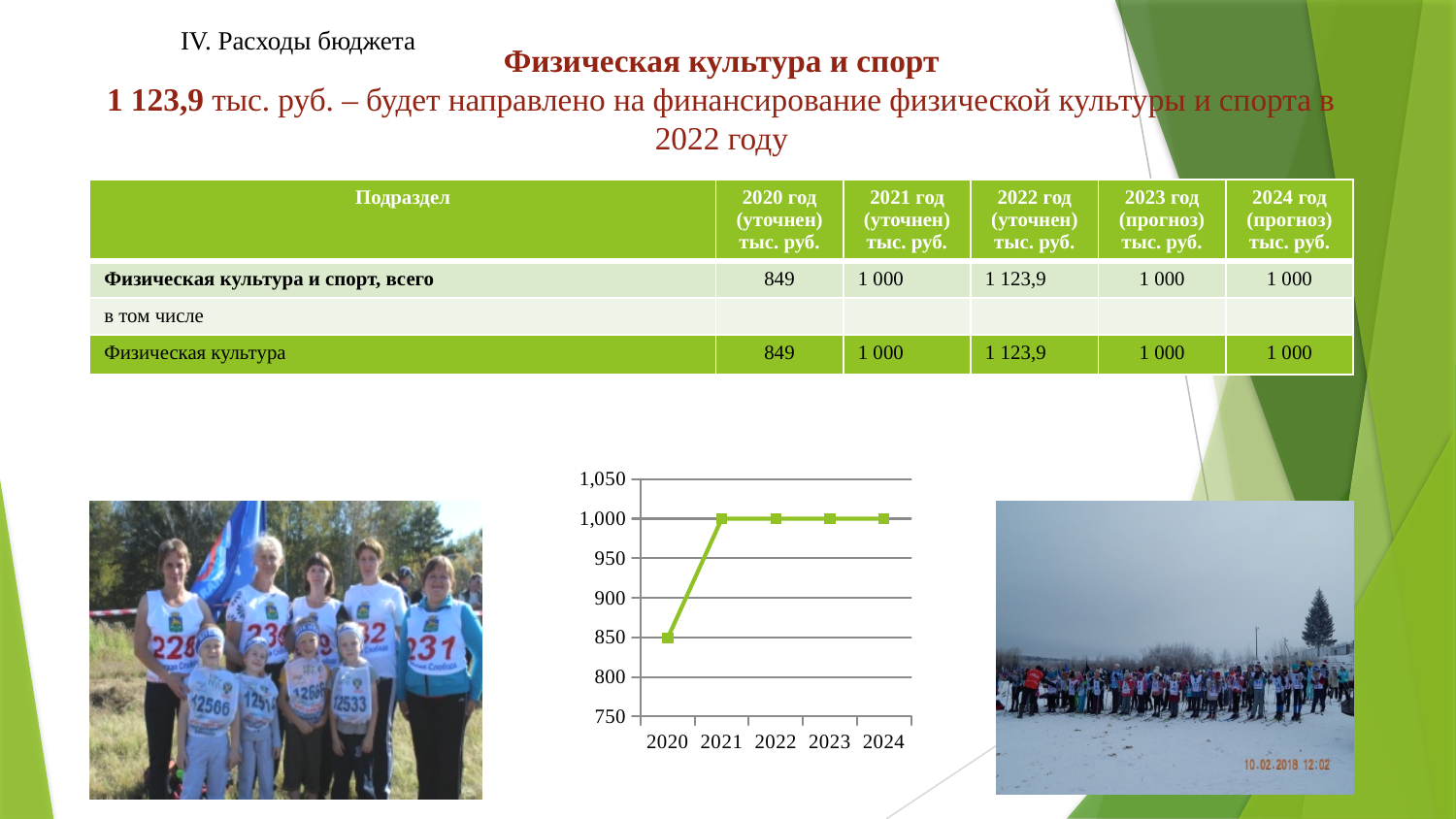
What is the highest tick value shown on the y axis of the chart? 1,050 Which year has the lowest value in the chart? 2020 Which year has the larger value in the chart, 2020 or 2021? 2021 Is the value for 2020 in the chart greater or less than 900? less Do the values in the chart rise or fall from 2020 to 2021? rise What is the first year shown on the x axis of the chart? 2020 Is the value for 2023 in the chart greater or less than 950? greater What is the value plotted for 2021 in the chart? 1,000 What kind of chart is shown on the slide? line chart What is the value plotted for 2024 in the chart? 1,000 How many years are plotted on the x axis of the chart? 5